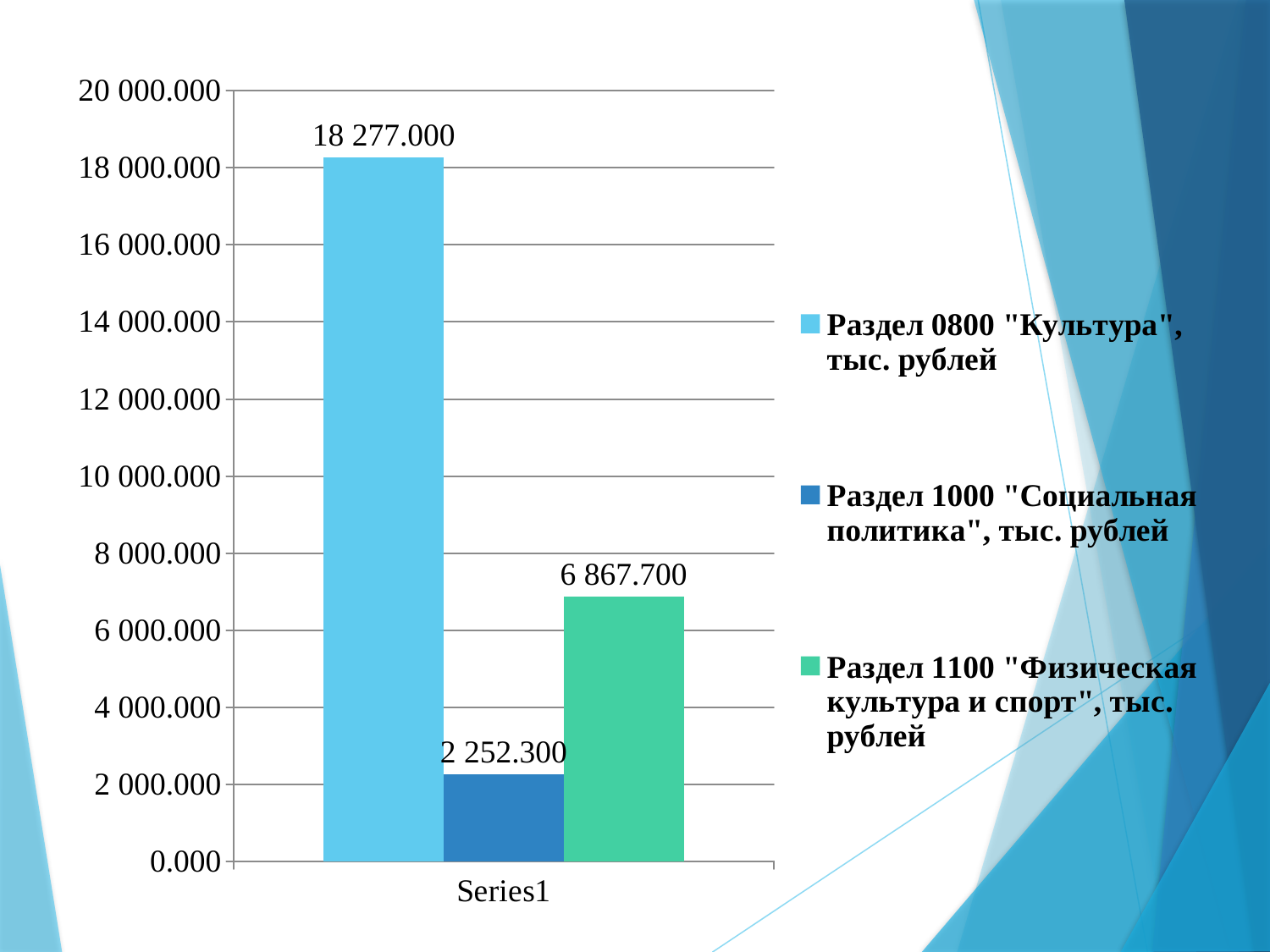
What is the value for Раздел 1100 "Физическая культура и спорт", тыс. рублей? 6 867.700 What is the difference between the values for Раздел 0800 "Культура" and Раздел 1100 "Физическая культура и спорт"? 11 409.300 How many series does the legend list? 3 What is the value for Раздел 1000 "Социальная политика", тыс. рублей? 2 252.300 What is the difference between the values for Раздел 1100 "Физическая культура и спорт" and Раздел 1000 "Социальная политика"? 4 615.400 What is the value for Раздел 0800 "Культура", тыс. рублей? 18 277.000 What kind of chart is shown on the slide? bar chart What is the category label shown on the x axis? Series1 Is the value for Раздел 0800 "Культура" greater or less than 16 000.000? greater Which series has the lowest value? Раздел 1000 "Социальная политика", тыс. рублей Which is larger, the value for Раздел 1000 "Социальная политика" or the value for Раздел 1100 "Физическая культура и спорт"? Раздел 1100 "Физическая культура и спорт" Which series has the highest value? Раздел 0800 "Культура", тыс. рублей